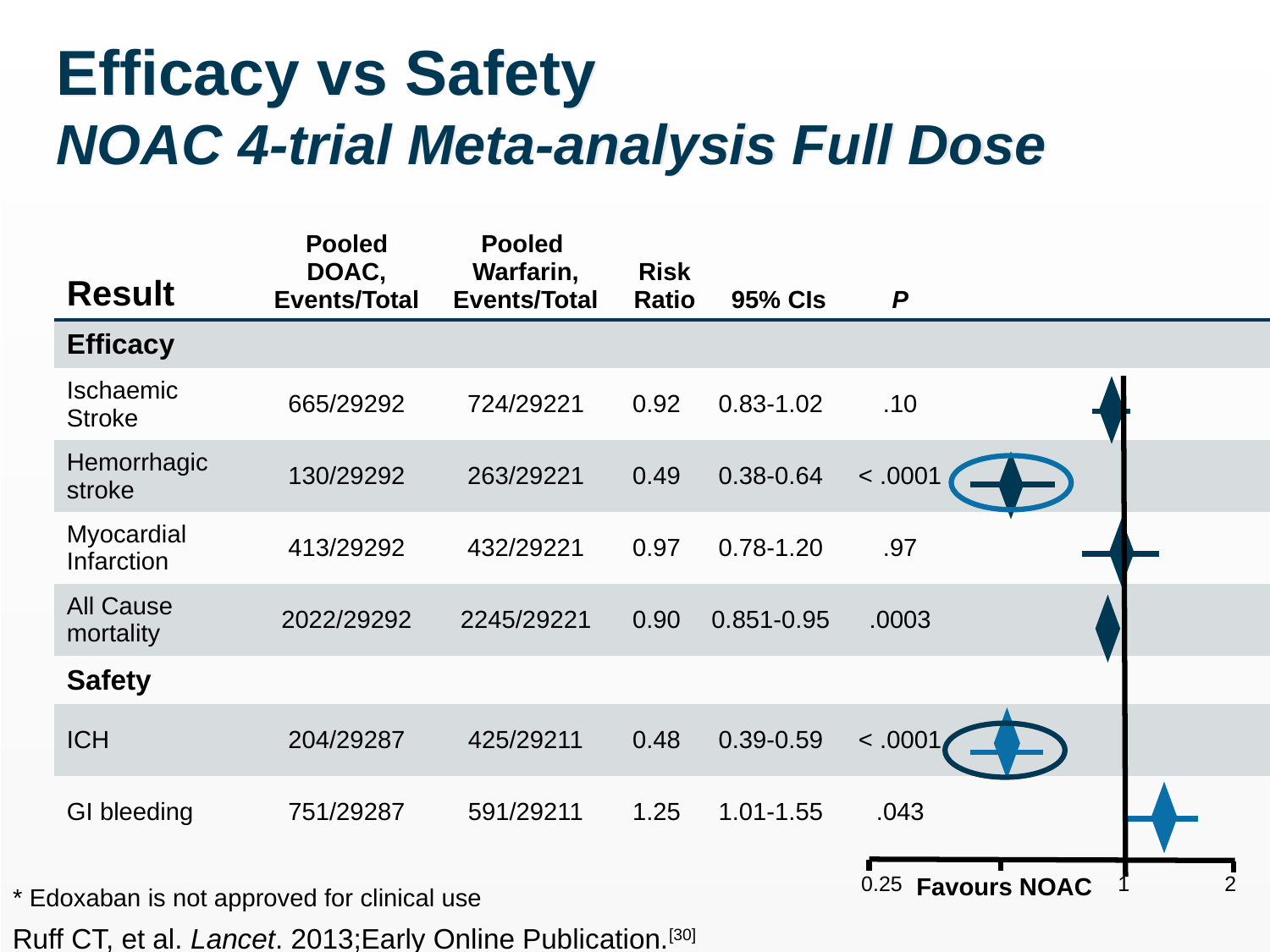
What is the risk ratio for GI bleeding? 1.25 Which outcome has the highest risk ratio? GI bleeding What kind of chart is shown on the right side of the slide? Forest plot Is the risk ratio for GI bleeding greater or less than 1? greater Which has the larger risk ratio, Myocardial Infarction or All Cause mortality? Myocardial Infarction What is the 95% CI for Hemorrhagic stroke? 0.38-0.64 What is the Pooled DOAC Events/Total for ICH? 204/29287 What is the risk ratio for ICH? 0.48 What is the difference between the risk ratio for GI bleeding and the risk ratio for Ischaemic Stroke? 0.33 What label appears below the x axis of the forest plot? Favours NOAC How many outcomes are plotted in the forest plot? 6 What is the P value for All Cause mortality? .0003